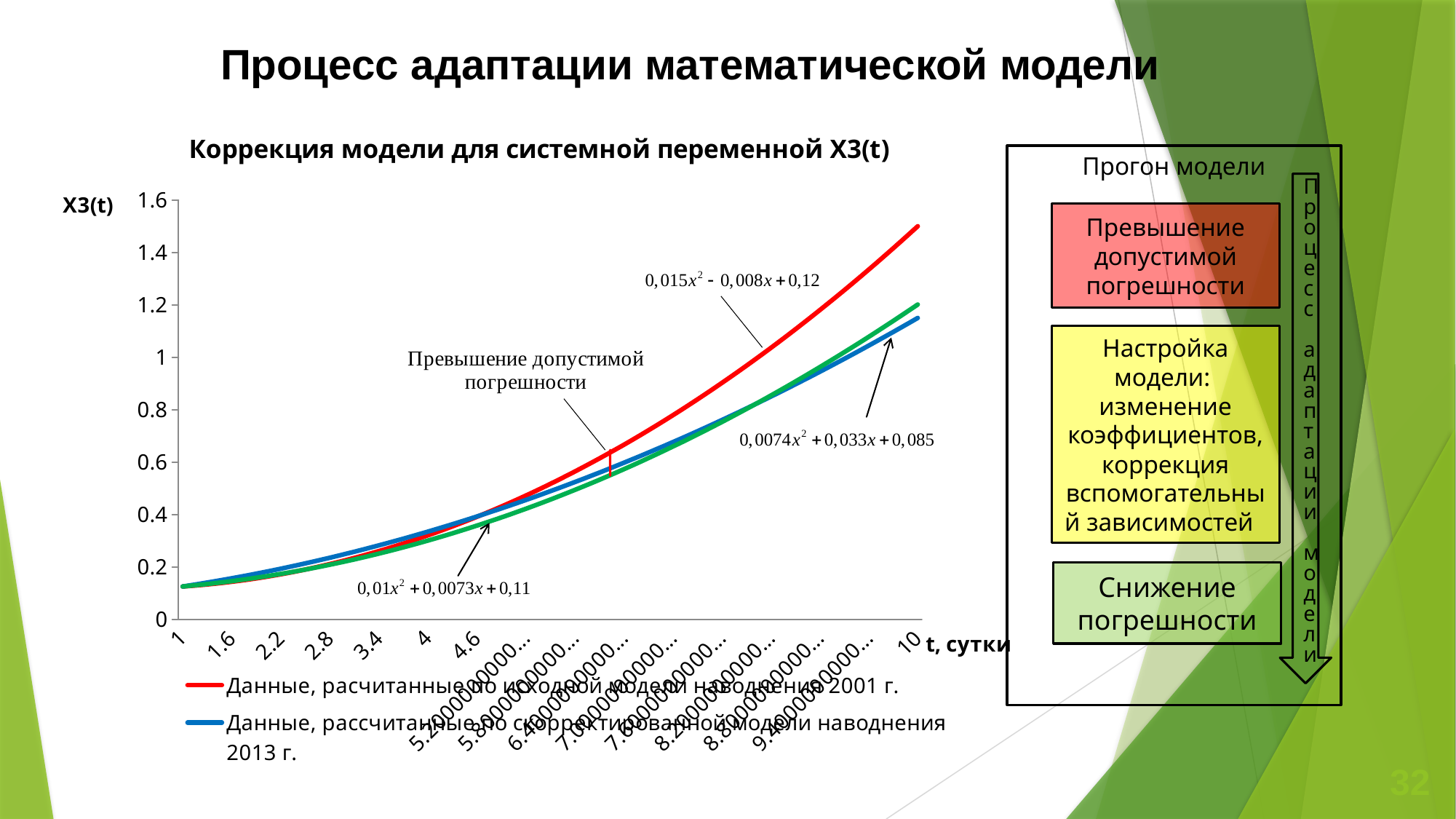
At t = 1, is the value of the red line greater or less than 0.2? less At t = 10, which line has the larger value: the red line or the blue line? the red line What is the title of the chart? Коррекция модели для системной переменной X3(t) What is the highest tick value shown on the y axis of the chart? 1.6 What kind of chart is shown on the slide? line chart Do the plotted lines rise or fall as t increases along the x axis? rise How many series does the chart legend list? 2 At t = 10, is the value of the red line (исходная модель наводнения 2001 г.) greater or less than 1.4? greater At t = 10, is the value of the blue line (скорректированная модель наводнения 2013 г.) greater or less than 1.2? less What is the label on the x axis of the chart? t, сутки